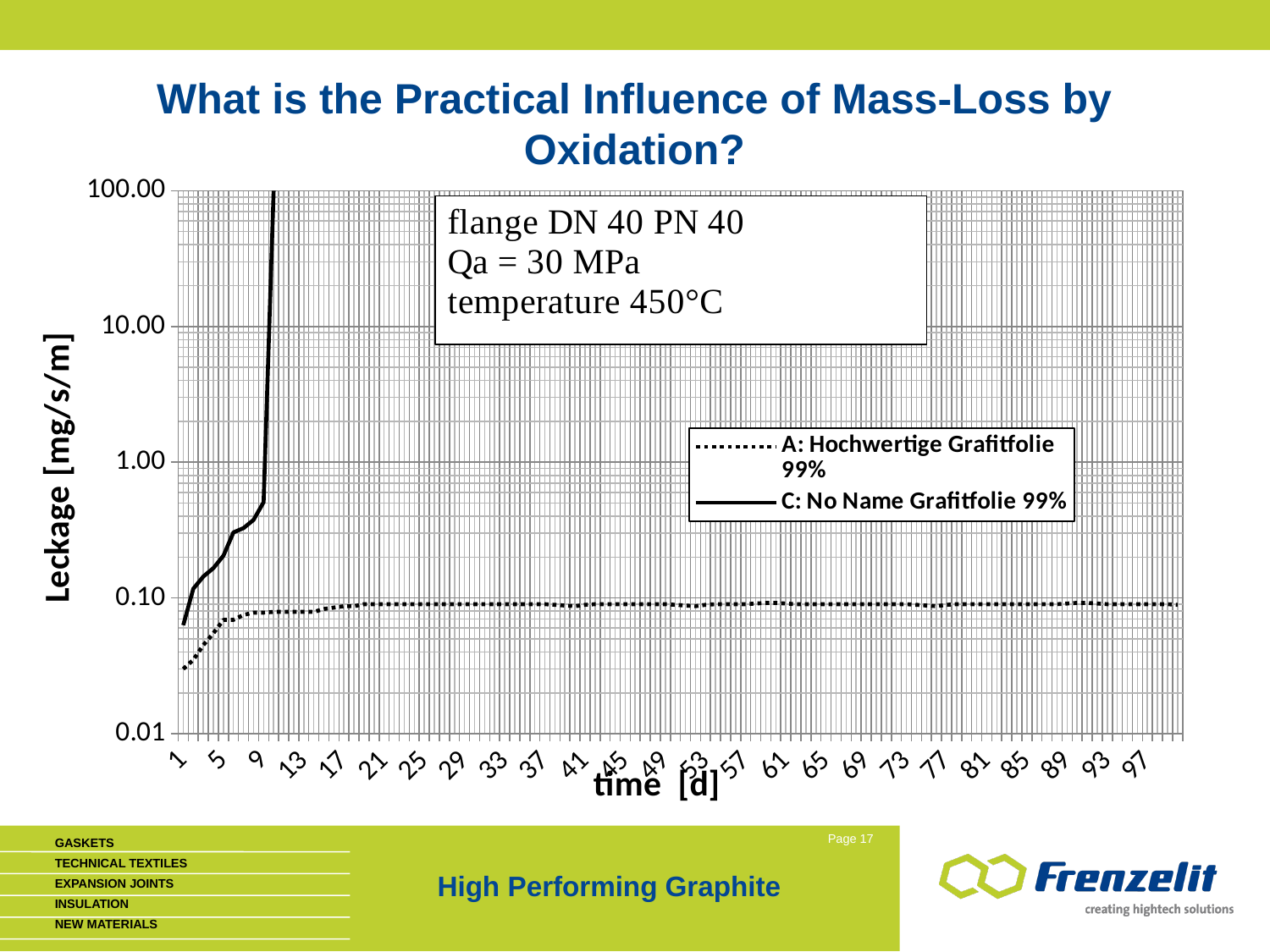
What is the label of the x axis? time [d] Is the value for series C: No Name Grafitfolie 99% at day 9 greater or less than 1.00? less Is the value for series C: No Name Grafitfolie 99% at day 1 greater or less than 0.10? less Which series is drawn with a dotted line? A: Hochwertige Grafitfolie 99% Which series reaches the top of the chart (100.00) within the first 13 days? C: No Name Grafitfolie 99% How many series does the legend list? 2 What is the label of the y axis? Leckage [mg/s/m] Is the value for series A: Hochwertige Grafitfolie 99% at day 1 greater or less than 0.10? less At day 9, which series has the larger value, A: Hochwertige Grafitfolie 99% or C: No Name Grafitfolie 99%? C: No Name Grafitfolie 99% What kind of chart is shown on the slide? line chart